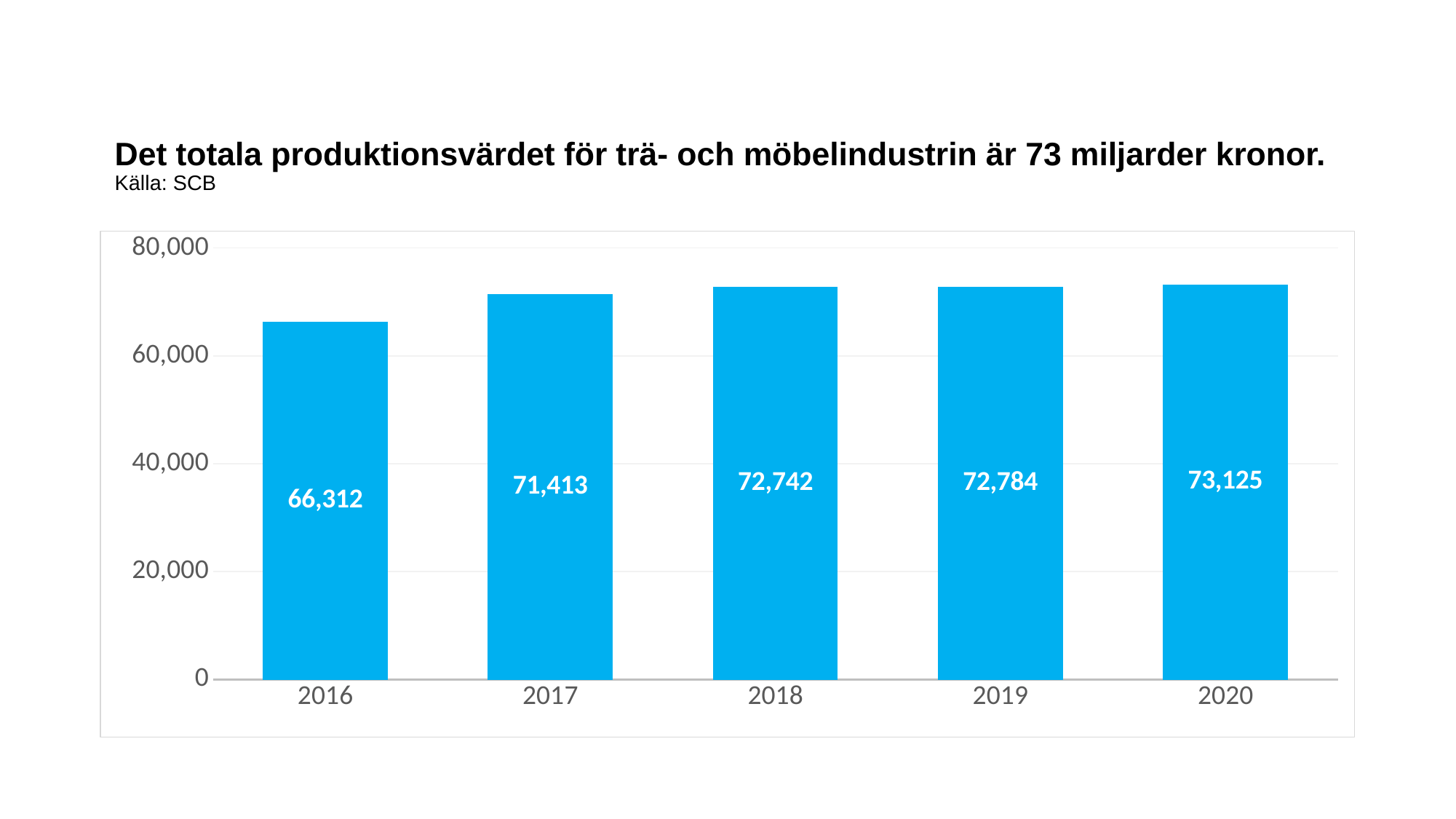
What is the value for 2018? 72,742 What is the difference between the values for 2017 and 2016? 5,101 Which year has the highest value? 2020 Do the values rise or fall from 2016 to 2020? Rise Which is larger, the value for 2017 or the value for 2019? 2019 Is the value for 2016 greater or less than 60,000? greater What is the value for 2016? 66,312 How many years are shown on the x axis? 5 What is the value for 2020? 73,125 What kind of chart is shown on the slide? Bar chart What is the difference between the values for 2020 and 2016? 6,813 Which year has the lowest value? 2016